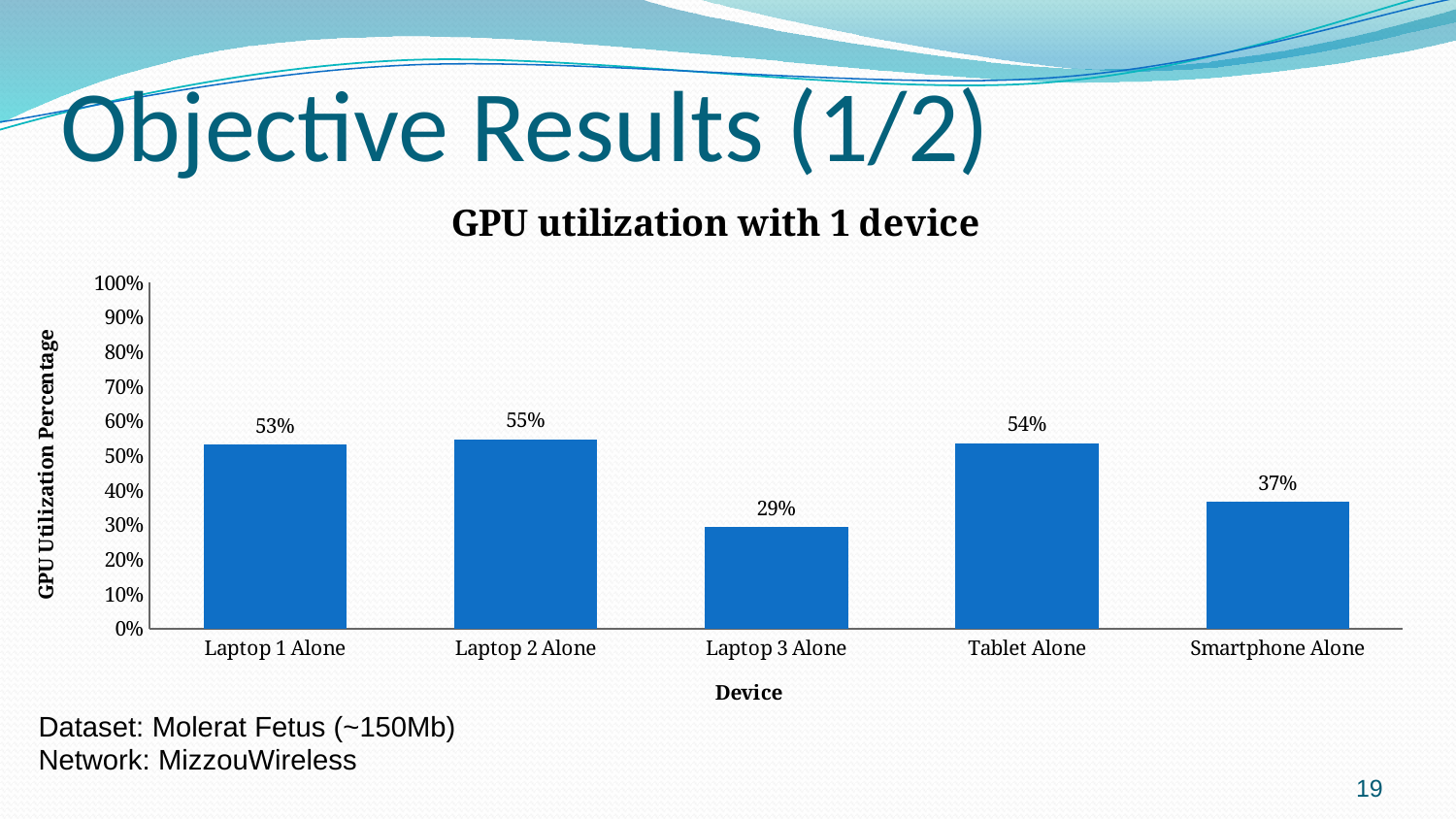
What is the GPU utilization percentage for Laptop 3 Alone? 29% What is the GPU utilization percentage for Laptop 1 Alone? 53% Which device has the lowest GPU utilization percentage? Laptop 3 Alone How many devices are shown on the x axis of the chart? 5 Is the GPU utilization for Tablet Alone greater or less than 50%? greater What kind of chart is shown on the slide? Bar chart What is the difference in GPU utilization between Tablet Alone and Smartphone Alone? 17% Which has a higher GPU utilization percentage, Laptop 3 Alone or Smartphone Alone? Smartphone Alone Which device has the highest GPU utilization percentage? Laptop 2 Alone What is the title of the chart? GPU utilization with 1 device What is the difference in GPU utilization between Laptop 2 Alone and Laptop 3 Alone? 26% What is the GPU utilization percentage for Smartphone Alone? 37%